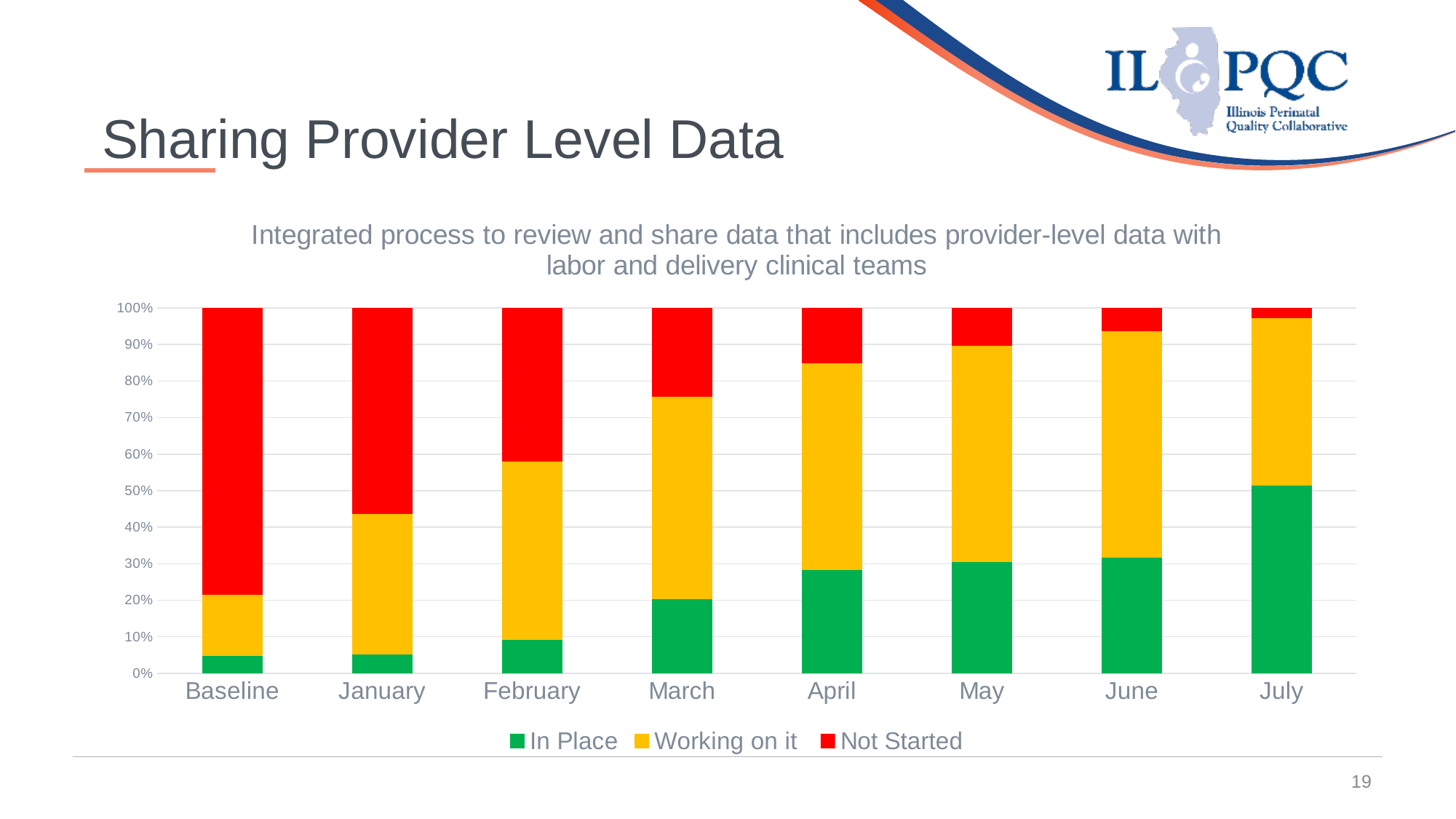
Is the In Place value for March greater or less than 30%? less How many categories are shown along the x axis? 8 Which is larger, the In Place value for March or for April? April What kind of chart is shown on the slide? Stacked bar chart Which category has the lowest Not Started value? July Which colour represents the Not Started series? Red How many series does the legend list? 3 Is the Not Started value for Baseline greater or less than 70%? greater Does the In Place value rise or fall from Baseline to July? rise Which category has the highest In Place value? July Is the In Place value for July greater or less than 40%? greater Which category has the highest Not Started value? Baseline